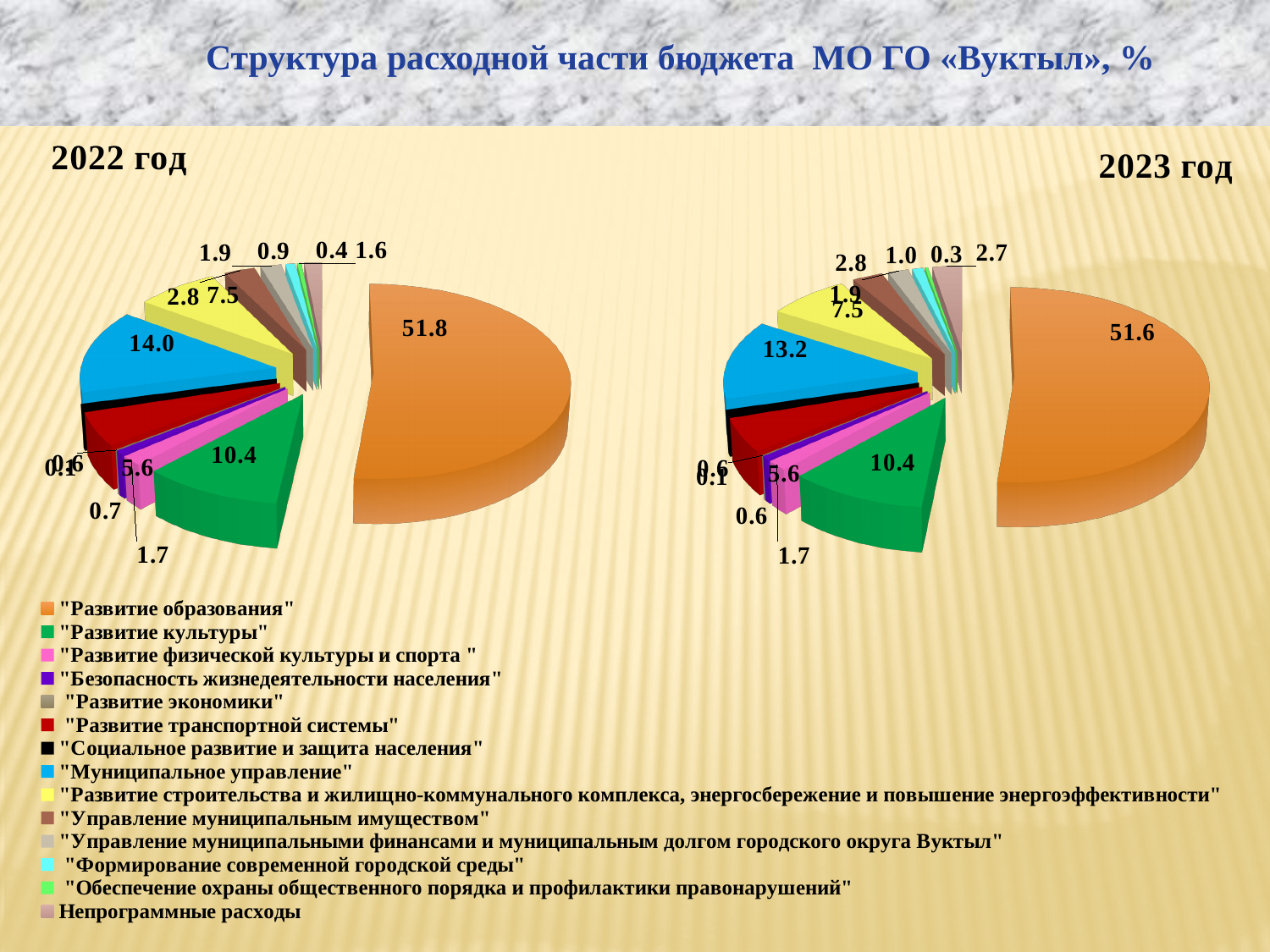
In the 2023 год chart, what is the value for "Развитие образования"? 51.6 By how much does the value for "Развитие образования" in the 2022 год chart exceed its value in the 2023 год chart? 0.2 In the 2022 год chart, what is the difference between "Муниципальное управление" and "Развитие культуры"? 3.6 In the 2022 год chart, which category has the largest share? "Развитие образования" In the 2022 год chart, what is the value for "Развитие образования"? 51.8 In the 2023 год chart, what is the value for "Муниципальное управление"? 13.2 In the 2022 год chart, what is the value for "Муниципальное управление"? 14.0 What colour represents "Развитие образования" in the charts? Orange How many categories does the legend list? 14 What kind of chart is used on this slide for the 2022 год and 2023 год data? Pie chart In the 2023 год chart, which is larger: "Развитие культуры" or "Развитие строительства и жилищно-коммунального комплекса, энергосбережение и повышение энергоэффективности"? "Развитие культуры" In the 2023 год chart, what is the value for "Развитие культуры"? 10.4